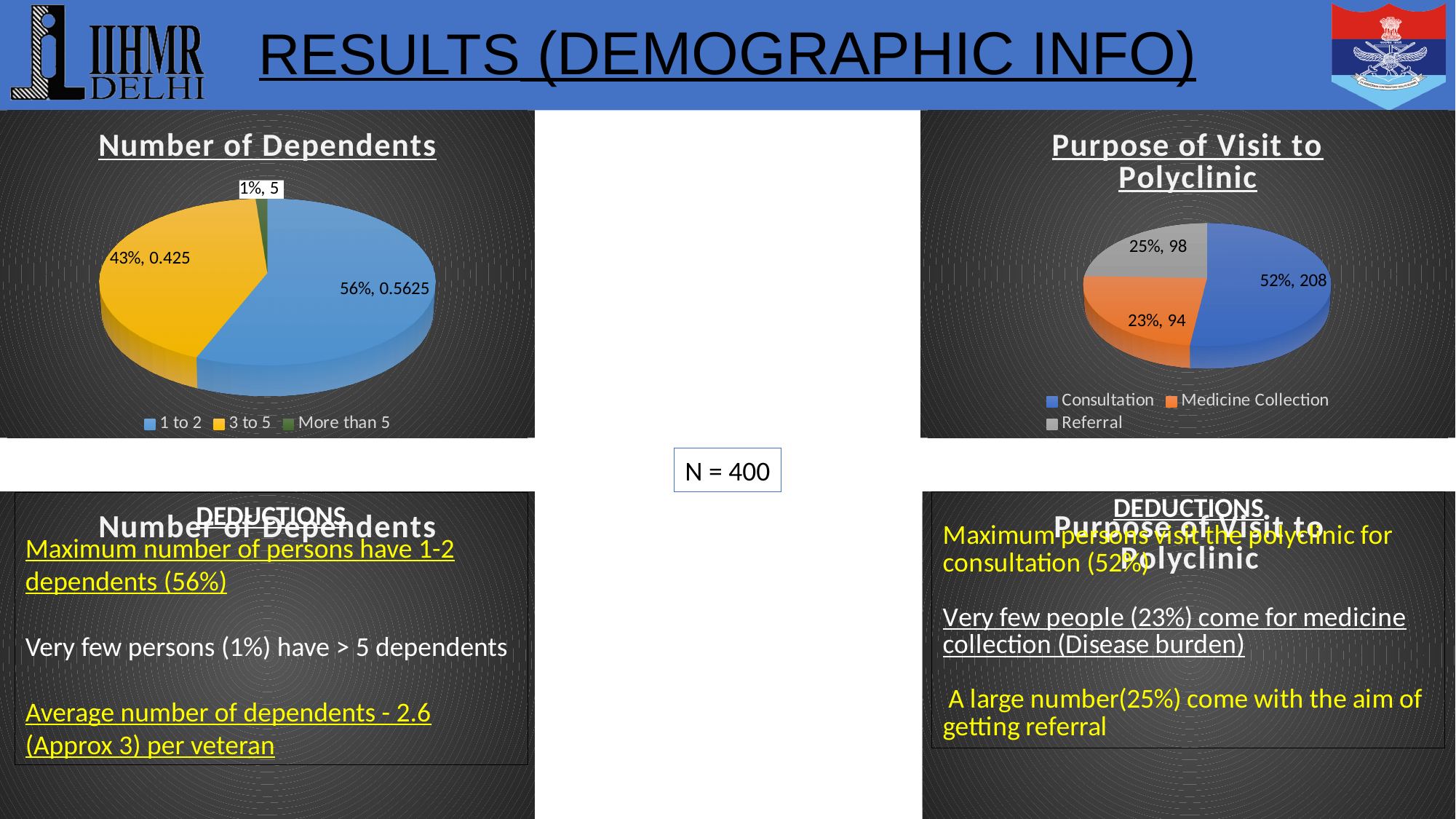
In the 'Number of Dependents' chart, what percentage share is shown for the '1 to 2' slice? 56% In the 'Purpose of Visit to Polyclinic' chart, which category has the largest slice? Consultation In the 'Purpose of Visit to Polyclinic' chart, what value is shown for Medicine Collection? 94 In the 'Purpose of Visit to Polyclinic' chart, what percentage share is shown for Referral? 25% How many categories does the legend of the 'Number of Dependents' chart list? 3 What kind of chart is the 'Number of Dependents' chart? Pie chart In the 'Purpose of Visit to Polyclinic' chart, what value is shown for Consultation? 208 In the 'Purpose of Visit to Polyclinic' chart, what is the total of the three slice values? 400 In the 'Number of Dependents' chart, which category has the smallest slice? More than 5 In the 'Number of Dependents' chart, what percentage share is shown for the '3 to 5' slice? 43% In the 'Purpose of Visit to Polyclinic' chart, what is the difference between the Consultation value and the Medicine Collection value? 114 In the 'Purpose of Visit to Polyclinic' chart, what colour is the Referral slice? Grey